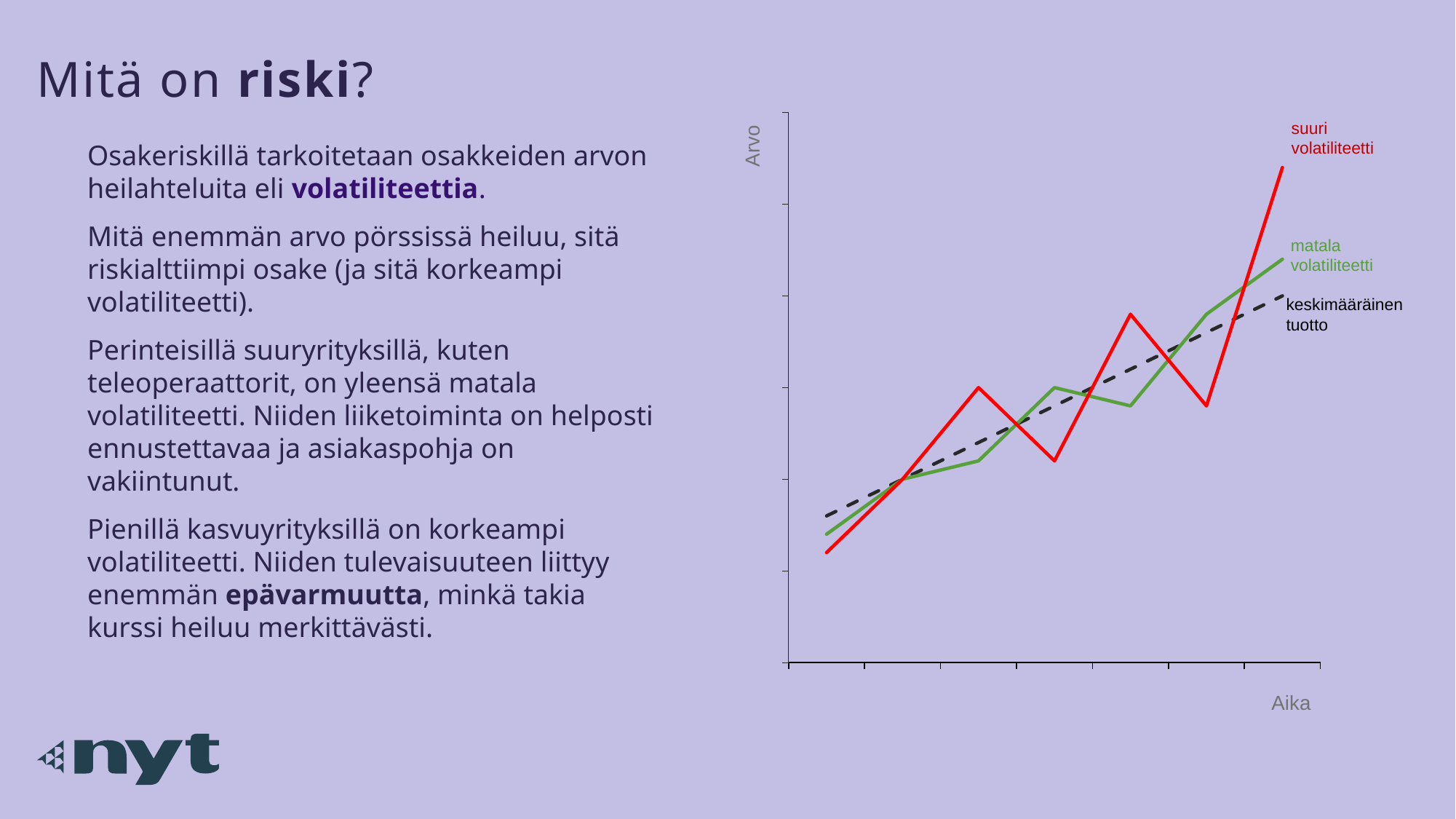
What kind of chart is shown on the slide? line chart Which series is drawn in red? suuri volatiliteetti What is the label of the vertical axis of the chart? Arvo At the right end of the chart, which series reaches the highest value? suuri volatiliteetti What is the label of the horizontal axis of the chart? Aika How many series (lines) are plotted on the chart? 3 At the right end of the chart, which series has the lowest value? keskimääräinen tuotto Overall, does the 'matala volatiliteetti' line rise or fall from left to right? rise At the right end of the chart, which is higher: 'suuri volatiliteetti' or 'matala volatiliteetti'? suuri volatiliteetti Which series shows the largest swings up and down over time? suuri volatiliteetti Overall, does the 'keskimääräinen tuotto' line rise or fall along the x axis? rise